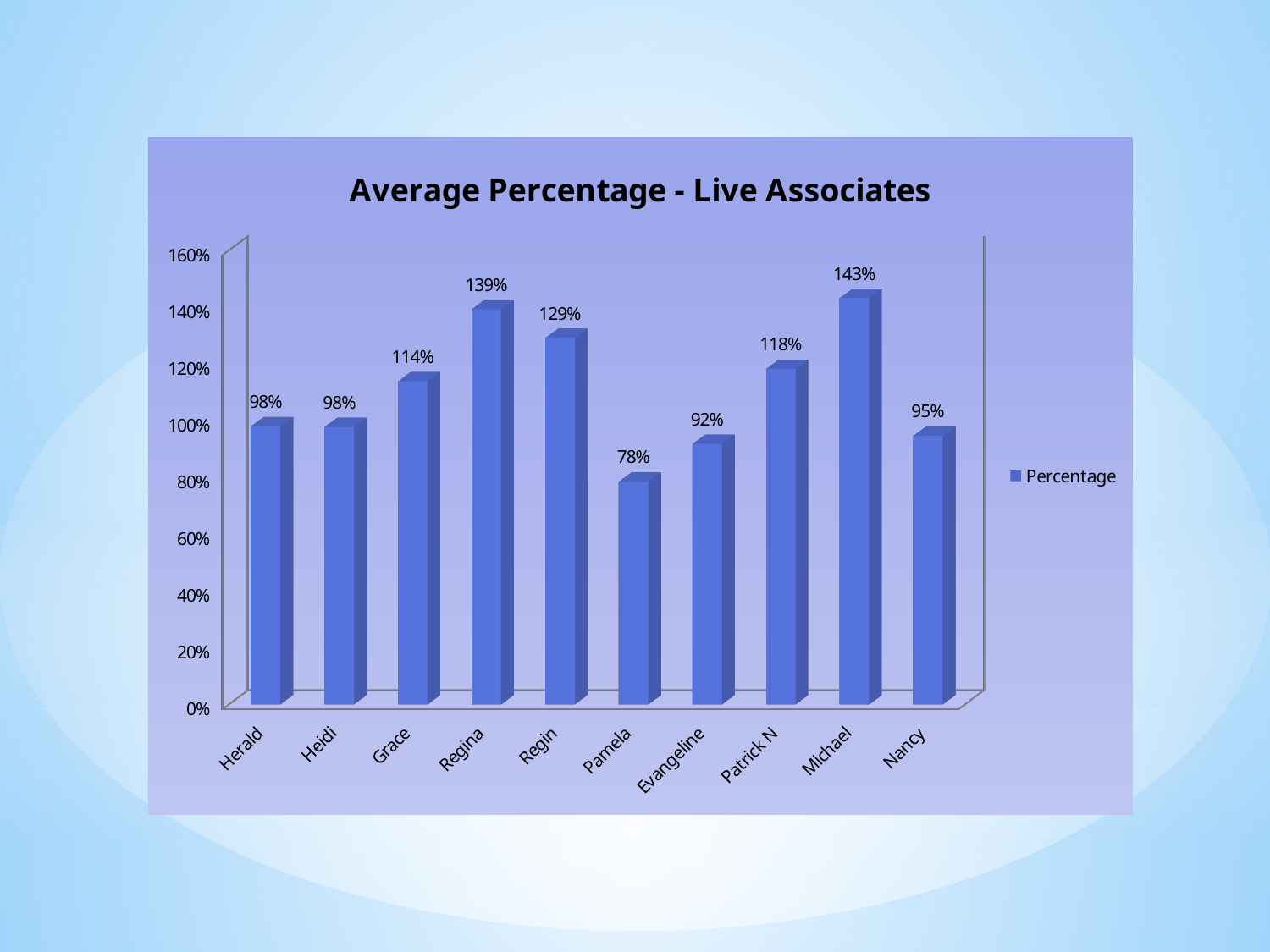
How many series does the legend list? 1 Which is larger, the value for Grace or the value for Regin? Regin What kind of chart is shown? bar chart Which category has the highest value? Michael What is the value for Pamela? 78% What is the value for Patrick N? 118% Is the value for Evangeline greater or less than 100%? less What is the difference between the values for Michael and Regina? 4% What is the title of the chart? Average Percentage - Live Associates What is the value for Regina? 139% Which category has the lowest value? Pamela How many categories are shown on the x axis? 10